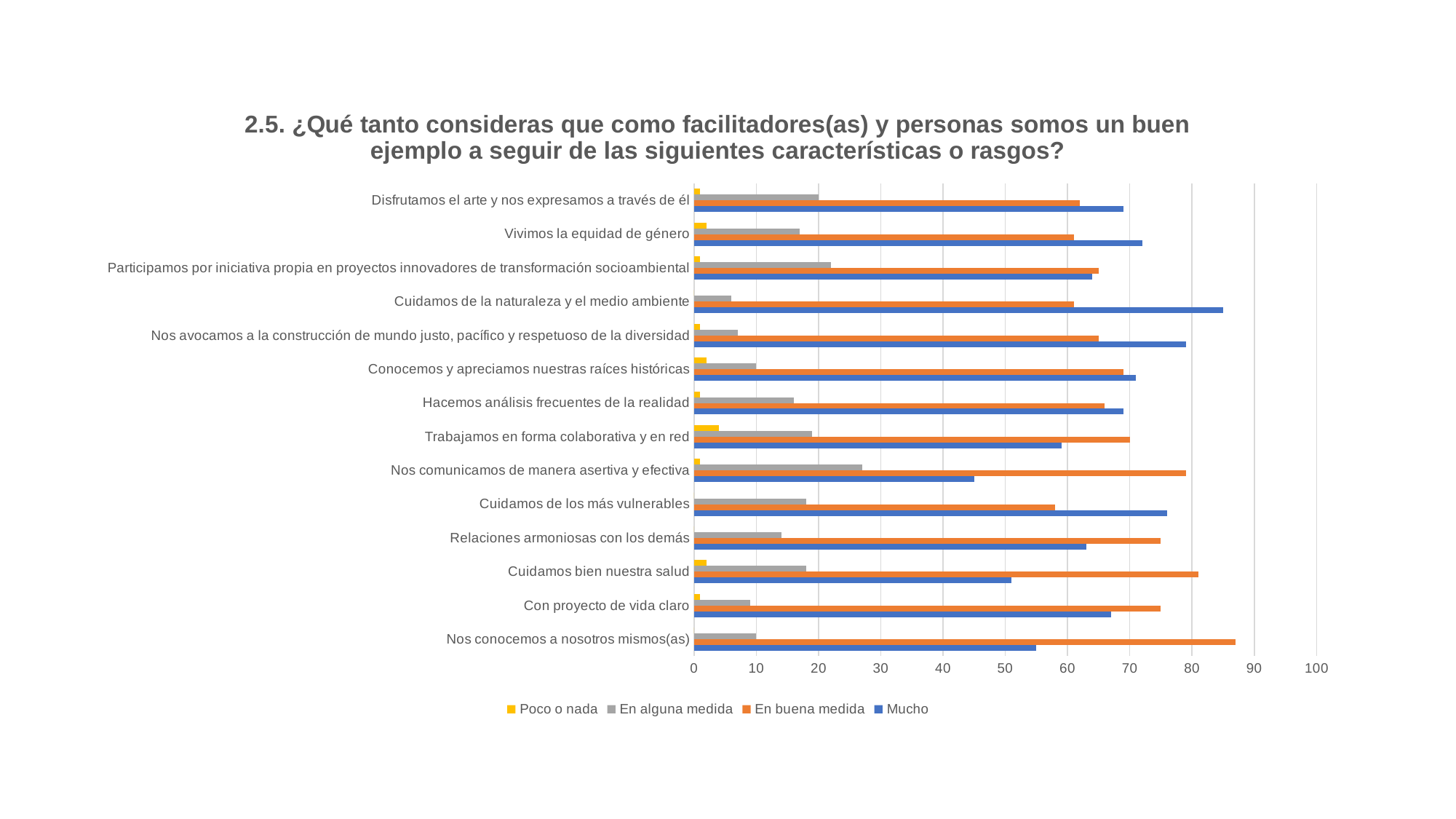
For 'Cuidamos bien nuestra salud', which is larger: the 'En buena medida' value or the 'Mucho' value? En buena medida Which category has the highest value for the 'En buena medida' series? Nos conocemos a nosotros mismos(as) Is the 'En buena medida' value for 'Nos conocemos a nosotros mismos(as)' greater or less than 80? greater How many series does the legend list? 4 Which category has the lowest value for the 'Mucho' series? Nos comunicamos de manera asertiva y efectiva Which category has the highest value for the 'Mucho' series? Cuidamos de la naturaleza y el medio ambiente Is the 'Mucho' value for 'Nos comunicamos de manera asertiva y efectiva' greater or less than 50? less Which series is shown in blue in the legend? Mucho What kind of chart is shown on the slide? bar chart How many categories are plotted on the chart? 14 For 'Vivimos la equidad de género', which is larger: the 'Mucho' value or the 'En buena medida' value? Mucho Is the 'Mucho' value for 'Cuidamos de la naturaleza y el medio ambiente' greater or less than 80? greater